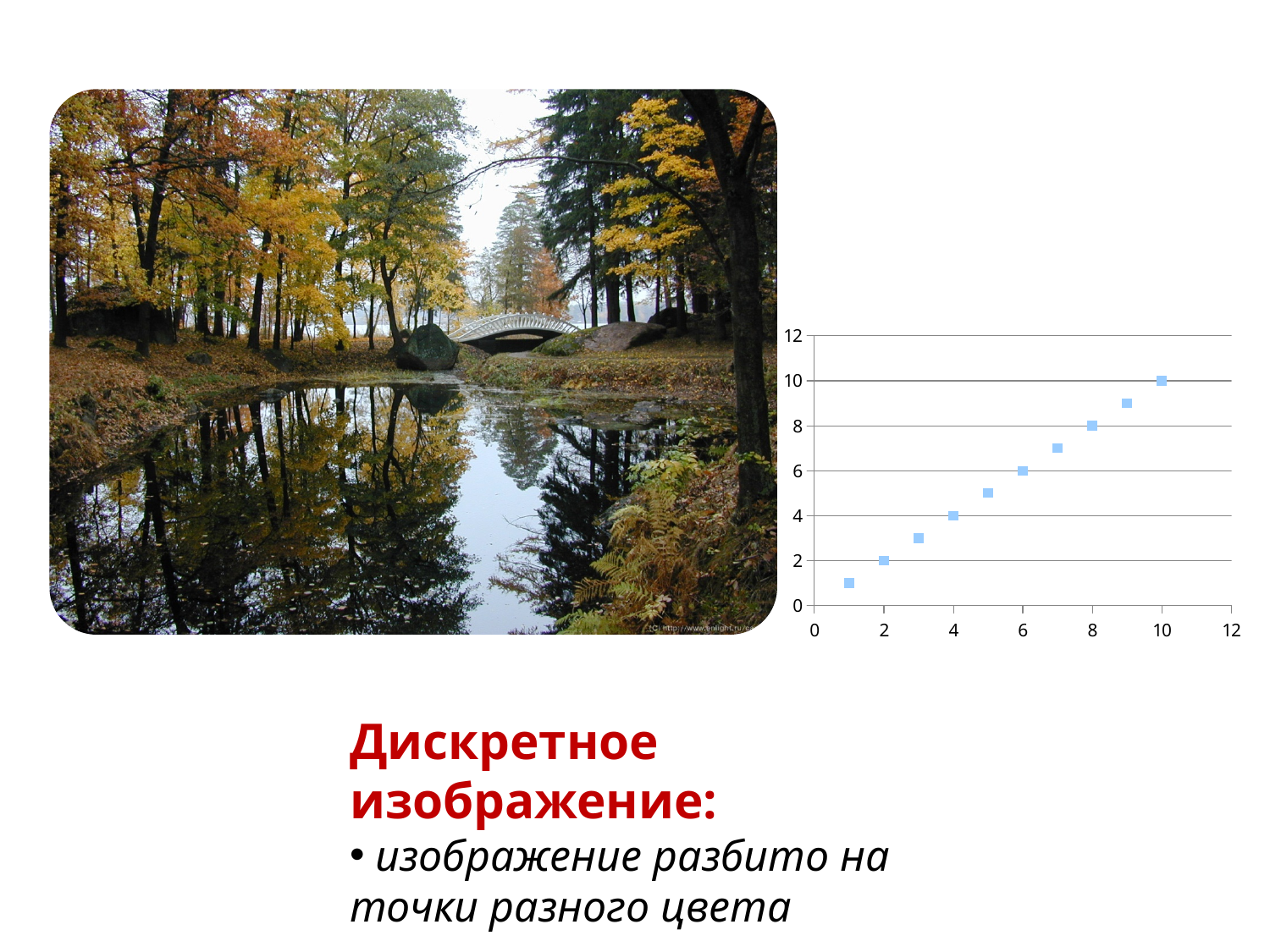
Which point has the larger y value: the one at x = 8 or the one at x = 4? x = 8 How many data points are plotted on the scatter chart? 10 What is the y value of the point at x = 2? 2 What is the y value of the point at x = 10? 10 What is the highest y value reached by any point on the chart? 10 What is the y value of the point at x = 6? 6 Do the plotted values rise or fall as x increases along the x axis? rise Is the y value of the point at x = 10 greater or less than 8? greater What is the difference between the y values of the points at x = 10 and x = 4? 6 What is the maximum value shown on the y axis of the chart? 12 What kind of chart is shown on the right side of the slide? scatter chart What is the y value of the point at x = 8? 8